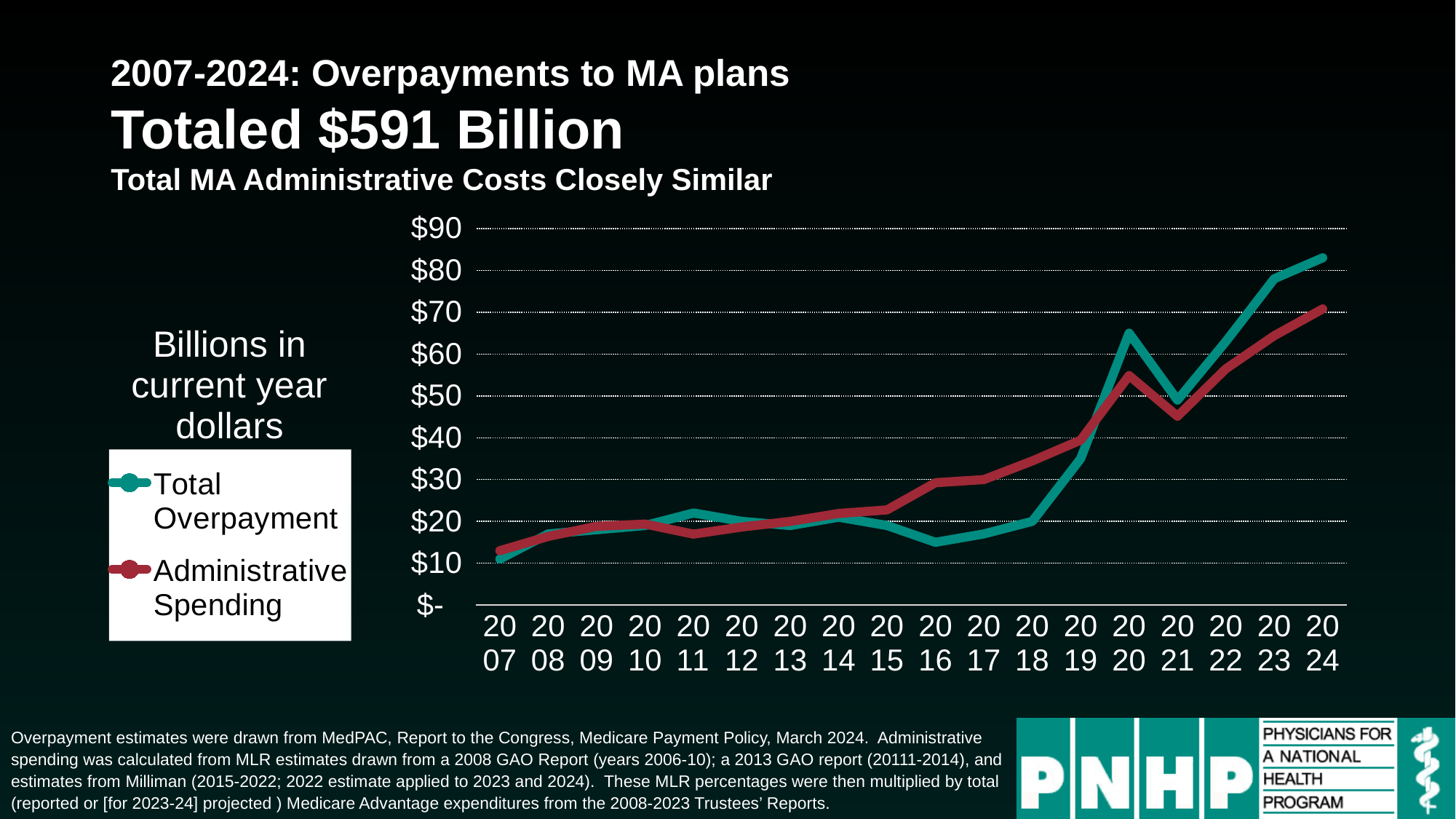
Is the Administrative Spending value for 2024 greater or less than $80? less How many years are plotted along the x axis? 18 In 2020, which series has the higher value, Total Overpayment or Administrative Spending? Total Overpayment Is the Total Overpayment value for 2016 greater or less than $20? less In which year is Total Overpayment highest? 2024 How many series does the legend list? 2 In which year is Total Overpayment lowest? 2007 Is the Total Overpayment value for 2020 greater or less than $60? greater In which year is Administrative Spending highest? 2024 In 2016, which series has the higher value, Total Overpayment or Administrative Spending? Administrative Spending What kind of chart is shown on the slide? line chart Does Administrative Spending rise or fall from 2021 to 2024? rise